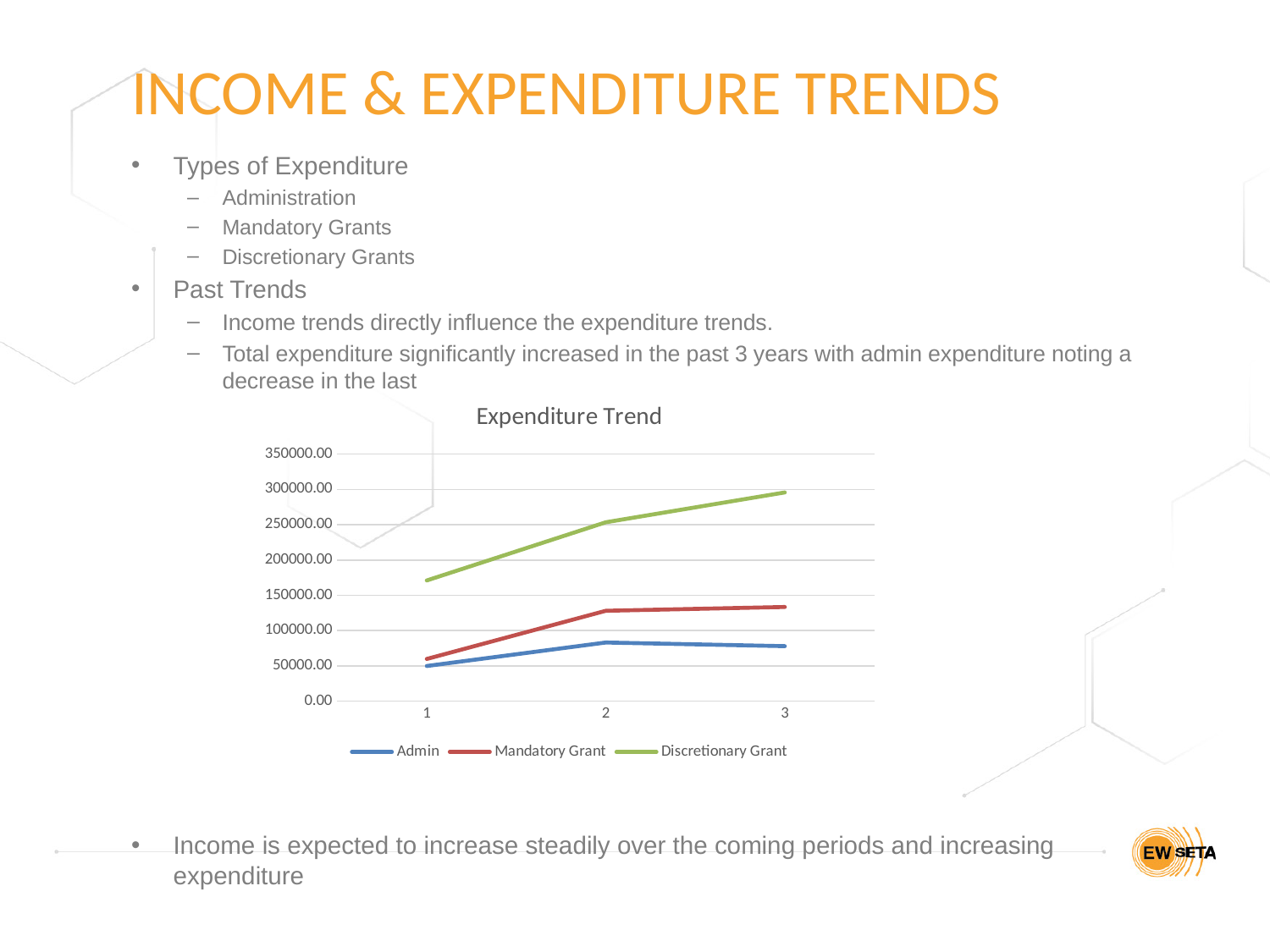
Is the value for Mandatory Grant at point 1 greater or less than 100000.00? less What kind of chart is the Expenditure Trend chart? line chart Is the value for Admin at point 2 greater or less than 100000.00? less What is the title of the chart on the slide? Expenditure Trend How many series does the legend of the Expenditure Trend chart list? 3 Which series has the highest value at point 3 in the Expenditure Trend chart? Discretionary Grant Does the Discretionary Grant series rise or fall from point 1 to point 3? rise How many points are plotted along the x axis for each series in the Expenditure Trend chart? 3